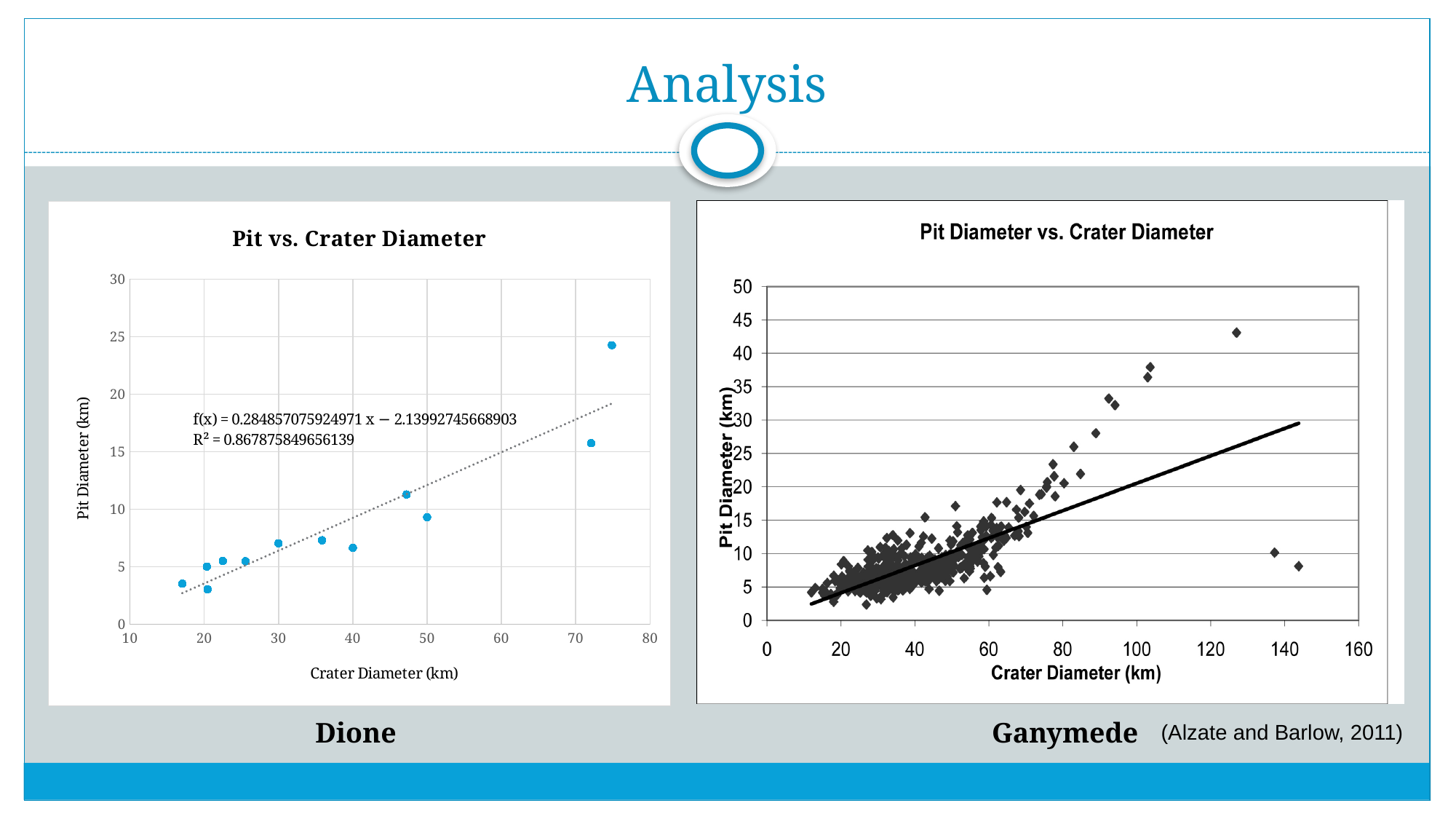
What kind of chart is the Ganymede chart titled "Pit Diameter vs. Crater Diameter"? Scatter chart What R² value is printed on the Dione chart? 0.867875849656139 In the Ganymede chart, is the pit diameter of the highest point greater or less than 40 km? greater What kind of chart is the Dione chart titled "Pit vs. Crater Diameter"? Scatter chart In the Ganymede chart, does the fitted line rise or fall as crater diameter increases? Rise Which chart contains more data points, the Dione chart or the Ganymede chart? Ganymede In the Ganymede chart, is the pit diameter of the point with the largest crater diameter (around 144 km) greater or less than 10 km? less How many data points are plotted in the Dione chart? 12 What is the x-axis label of the Dione chart? Crater Diameter (km) In the Dione chart, is the pit diameter of the lowest point greater or less than 5 km? less In the Dione chart, do pit diameters generally rise or fall as crater diameter increases? Rise